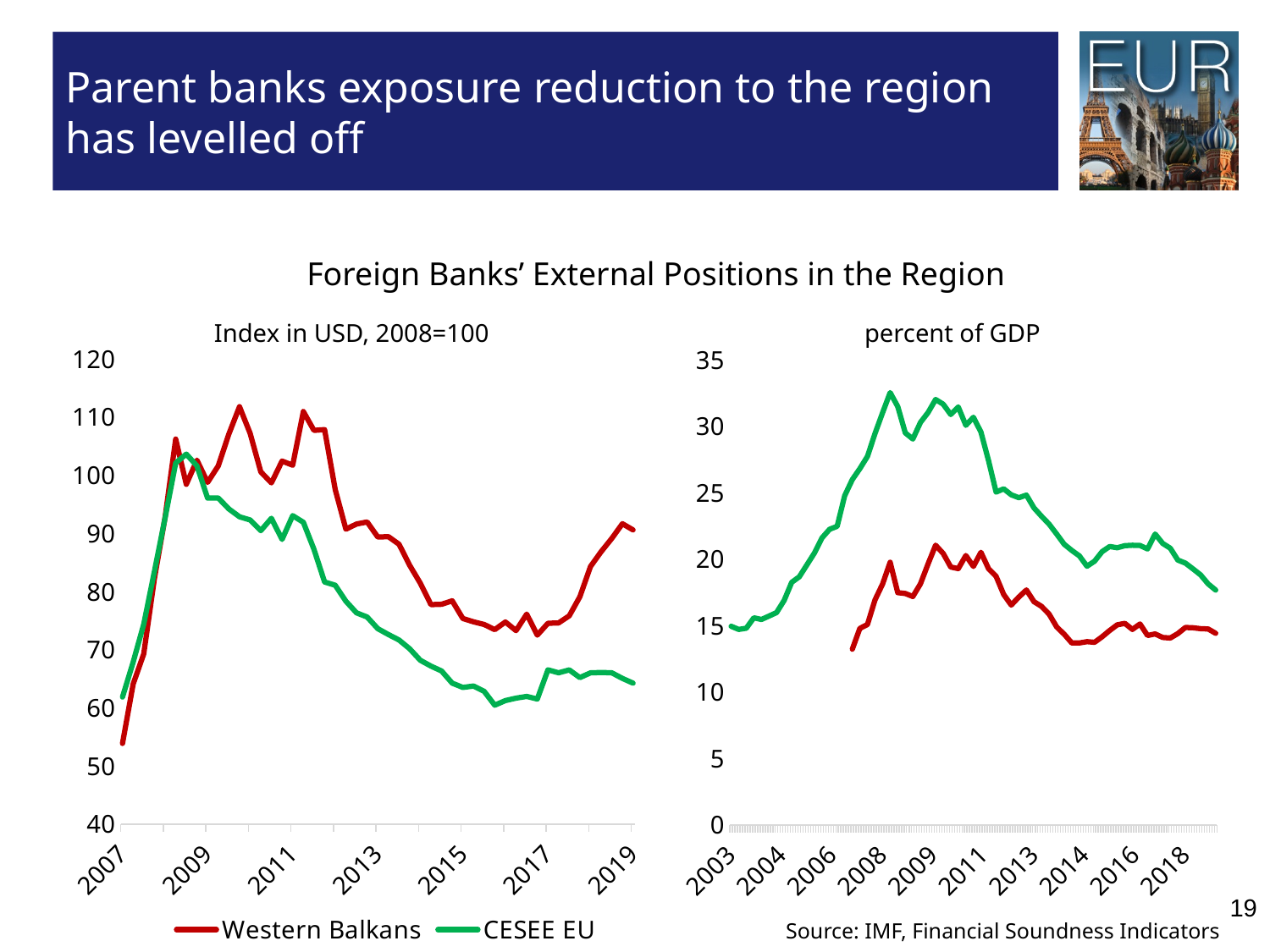
In the right chart (percent of GDP), is the value for Western Balkans in 2018 greater or less than 20? less In the left chart (Index in USD, 2008=100), is the value for Western Balkans in 2019 greater or less than 80? greater In the right chart (percent of GDP), does the CESEE EU line rise or fall between 2008 and 2014? fall What colour is the Western Balkans line in the charts? red In the right chart (percent of GDP), is the peak value for CESEE EU around 2008 greater or less than 30? greater What kind of chart is the left chart, 'Index in USD, 2008=100'? line chart In the right chart (percent of GDP), which series is higher in 2016, CESEE EU or Western Balkans? CESEE EU In the left chart (Index in USD, 2008=100), does the CESEE EU line rise or fall between 2009 and 2016? fall How many series does the legend list? 2 In the left chart (Index in USD, 2008=100), which series is higher in 2019, Western Balkans or CESEE EU? Western Balkans